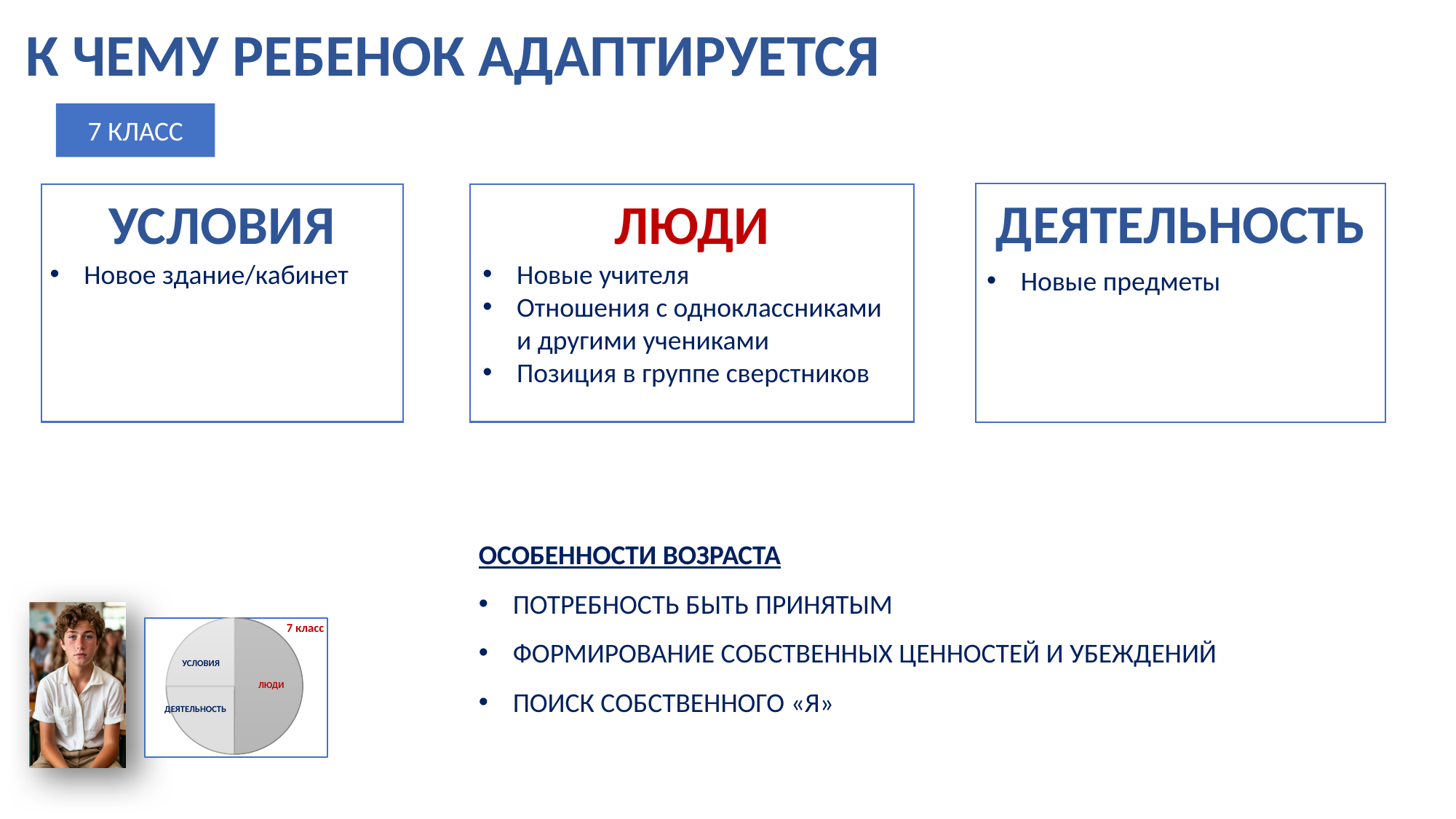
In the pie chart, which slice is larger: ЛЮДИ or ДЕЯТЕЛЬНОСТЬ? ЛЮДИ How many slices does the pie chart have? 3 What label is written in the top right corner of the pie chart? 7 класс Which slice of the pie chart is the largest? ЛЮДИ What kind of chart is shown at the bottom left of the slide? pie chart In the pie chart, which slice is larger: ЛЮДИ or УСЛОВИЯ? ЛЮДИ Which slice label in the pie chart is written in red? ЛЮДИ